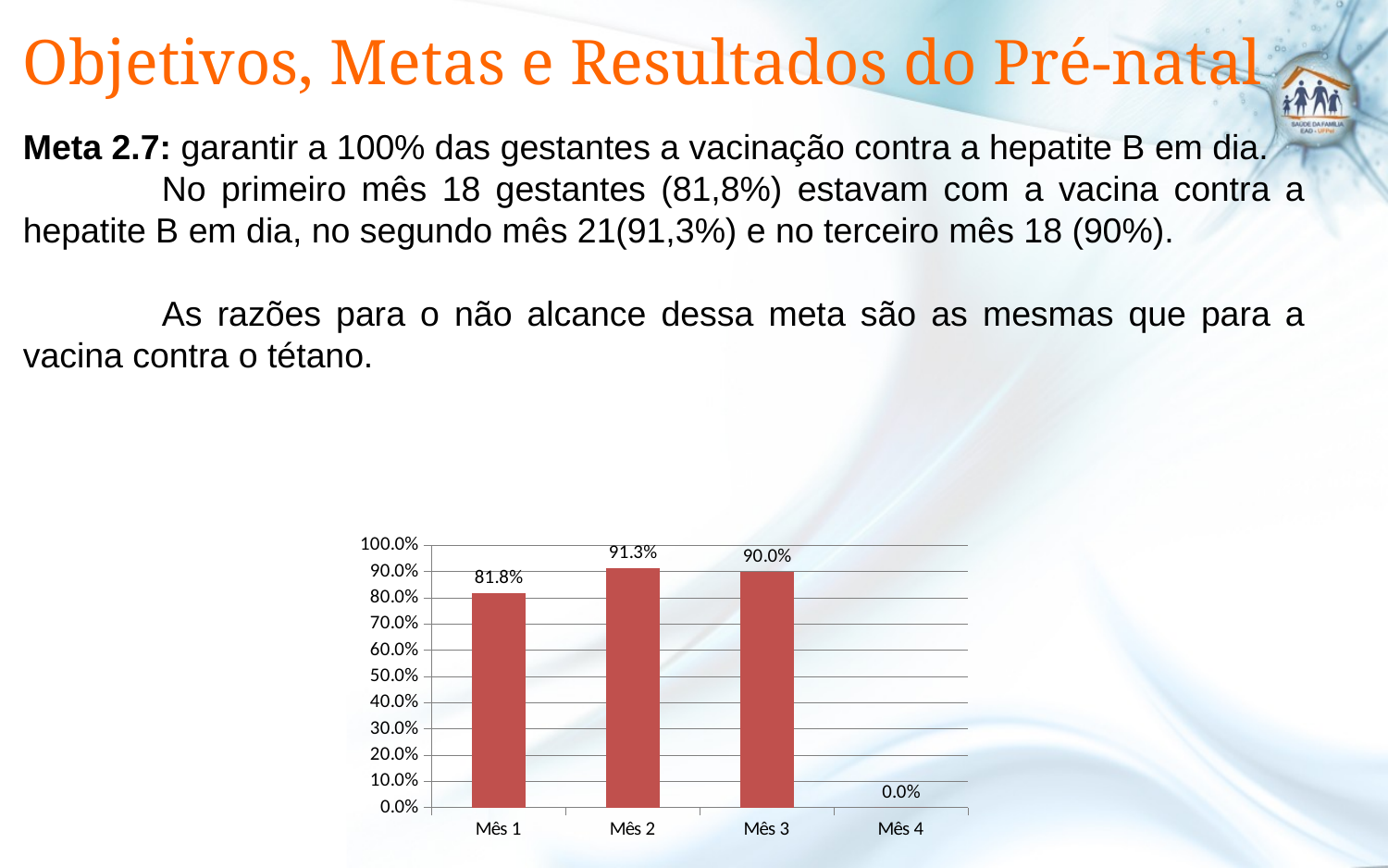
What is the value for Mês 2? 91.3% How many categories are shown on the x axis? 4 What is the value for Mês 3? 90.0% What is the value for Mês 1? 81.8% Which is larger, the value for Mês 1 or the value for Mês 3? Mês 3 Which category has the lowest value? Mês 4 What is the value for Mês 4? 0.0% What kind of chart is shown on the slide? bar chart Which category has the highest value? Mês 2 What colour are the bars in the chart? red Is the value for Mês 1 greater or less than 90.0%? less What is the difference between the values for Mês 2 and Mês 1? 9.5%